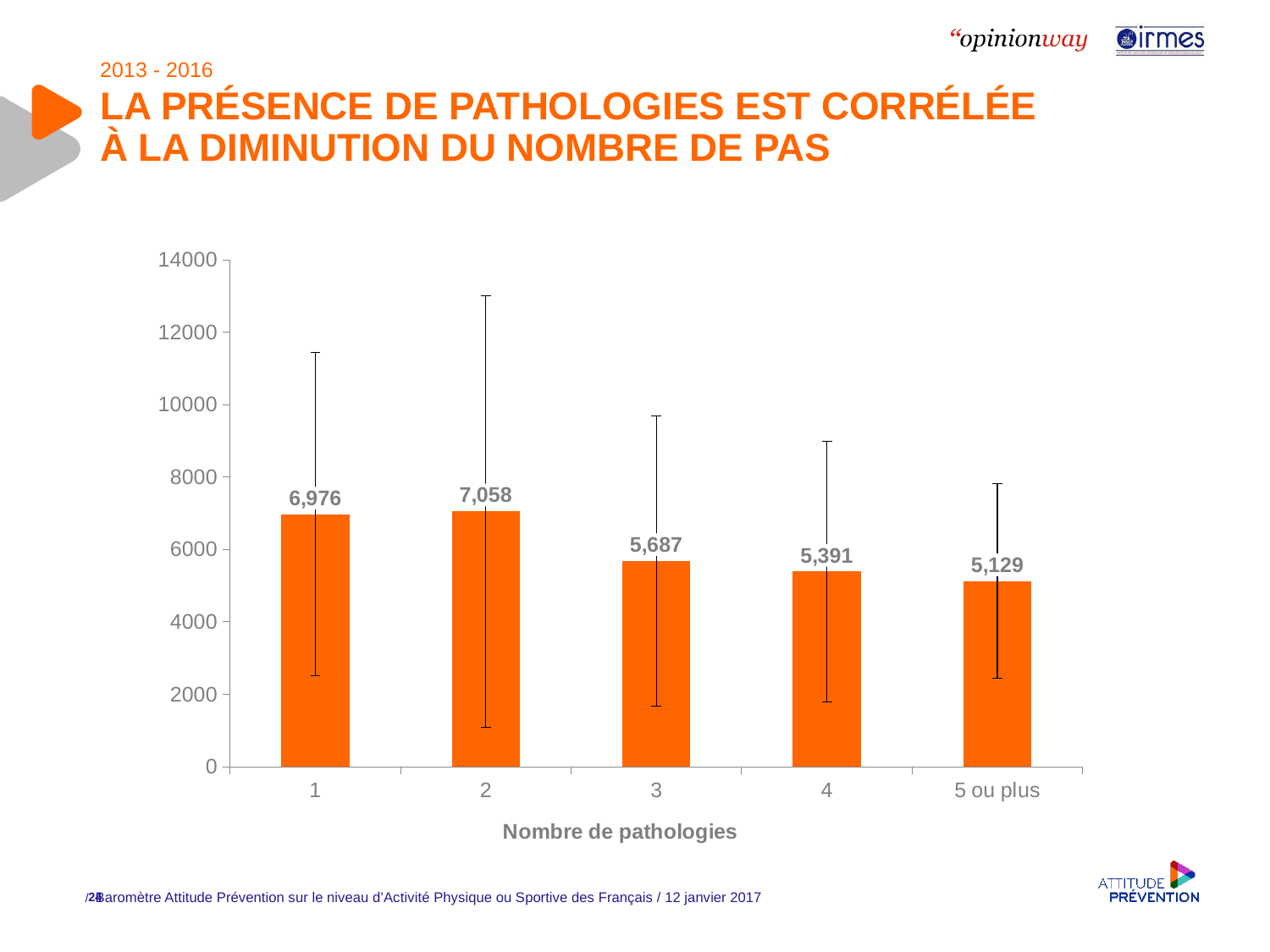
Is the value for 4 pathologies greater or less than 6000? less What kind of chart is this? bar chart What is the value for 3 pathologies? 5,687 What is the value for 2 pathologies? 7,058 What is the x axis title? Nombre de pathologies What is the value for 5 ou plus pathologies? 5,129 How many categories are shown on the x axis? 5 What is the difference between the values for 1 and 2 pathologies? 82 What is the difference between the values for 3 and 4 pathologies? 296 Which category has the lowest value? 5 ou plus Which is larger, the value for 1 pathology or the value for 4 pathologies? 1 Which category has the highest value? 2